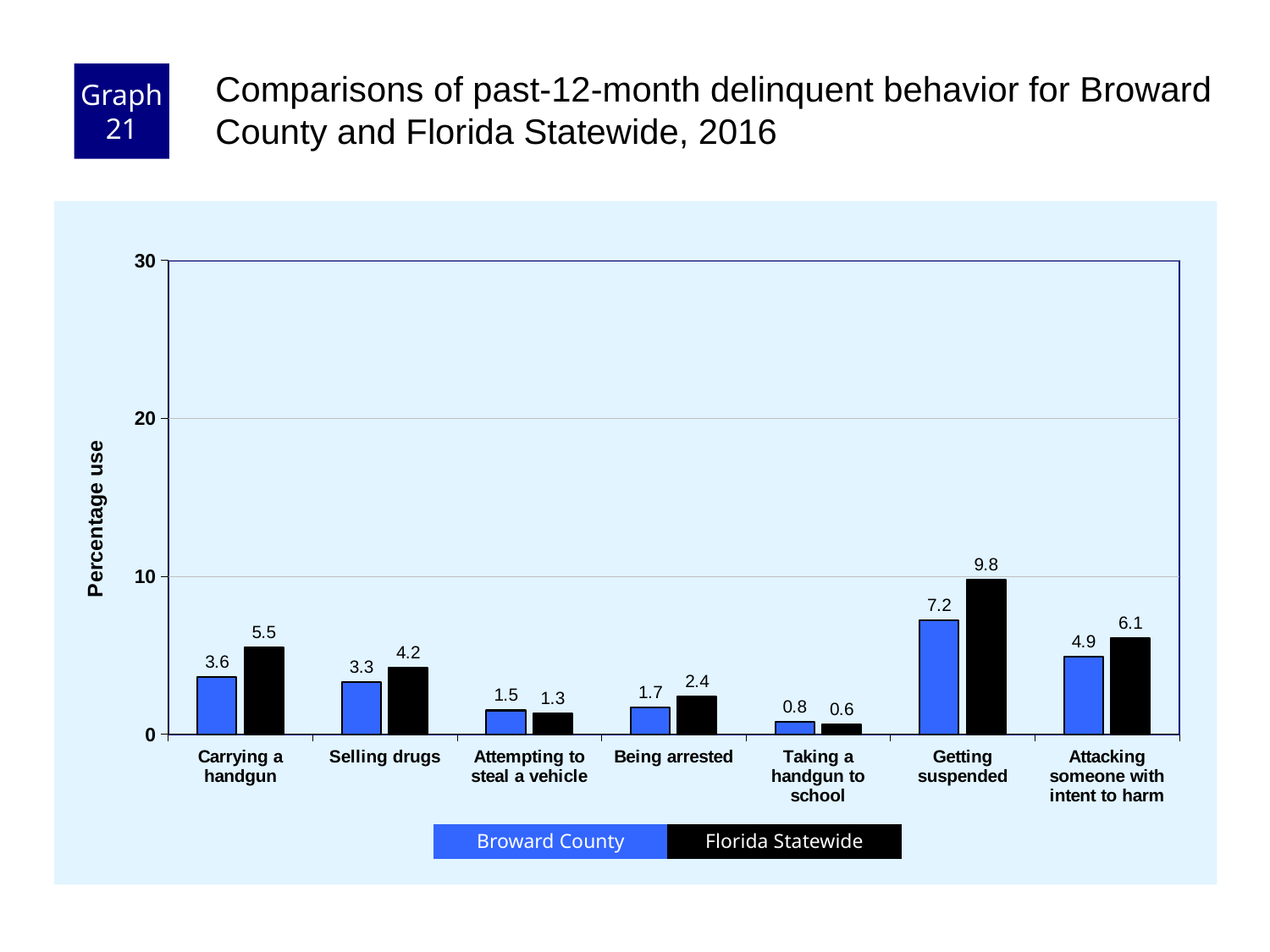
What is the label of the y axis? Percentage use Is the Florida Statewide value for Getting suspended greater or less than 10? less How many behavior categories are shown on the x axis? 7 Which category has the highest Florida Statewide value? Getting suspended What is the Broward County value for Taking a handgun to school? 0.8 What is the Florida Statewide value for Carrying a handgun? 5.5 What kind of chart is shown on the slide? Bar chart How many series does the legend list? 2 What is the Broward County value for Getting suspended? 7.2 What is the difference between the Florida Statewide and Broward County values for Getting suspended? 2.6 Which is larger for Attempting to steal a vehicle: Broward County or Florida Statewide? Broward County Which category has the lowest Broward County value? Taking a handgun to school